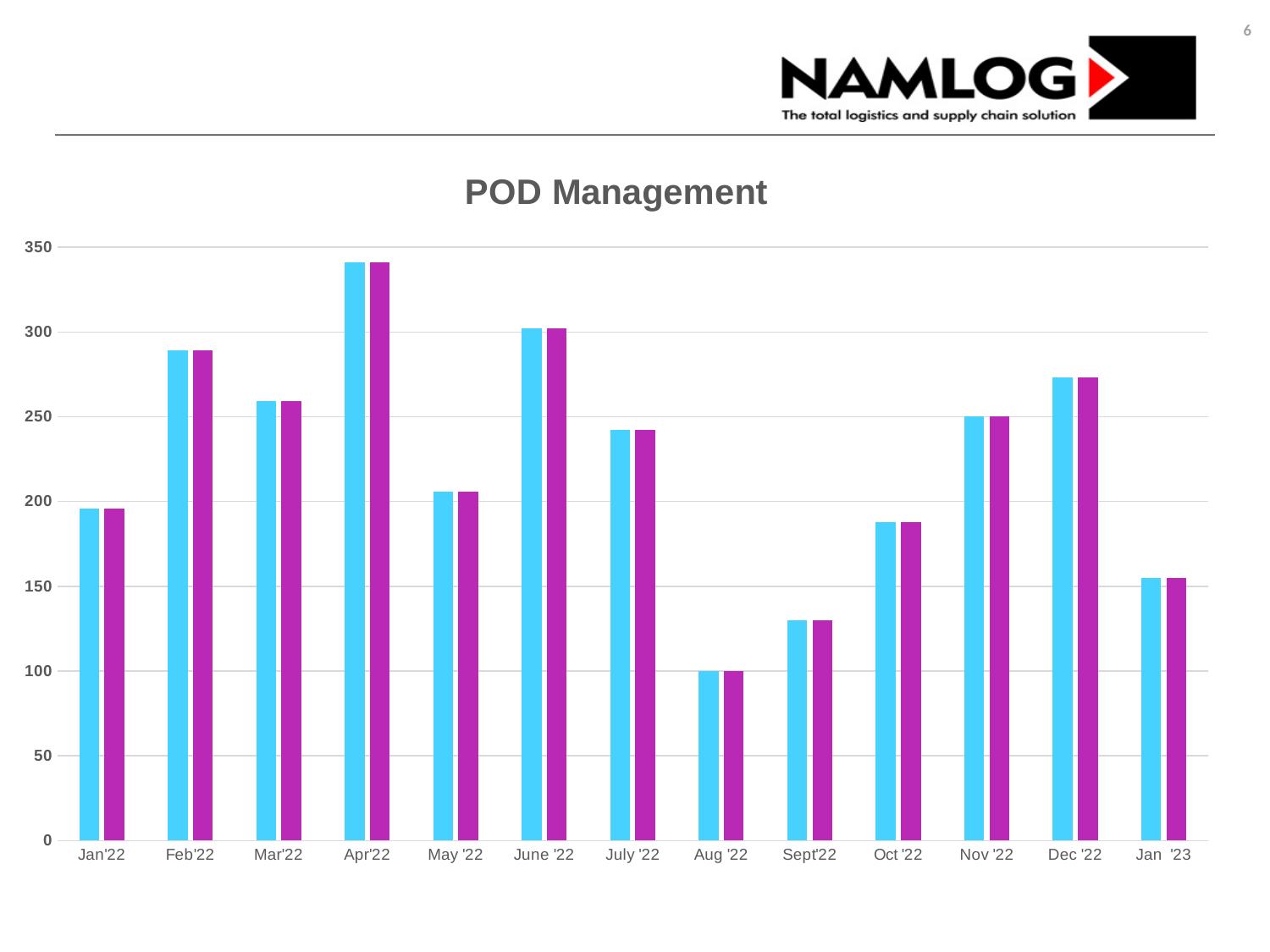
What value do the bars for Aug '22 reach on the axis? 100 What is the title of the chart? POD Management Is the value for Apr'22 greater or less than 300? greater Is the value for Sept'22 greater or less than 150? less Which month has the lowest bars in the chart? Aug '22 What kind of chart is shown on the slide? bar chart Which is larger, the value for Feb'22 or the value for Mar'22? Feb'22 How many months are shown on the x axis of the chart? 13 Is the value for Dec '22 greater or less than 250? greater What value do the bars for Nov '22 reach on the axis? 250 Which month has the highest bars in the chart? Apr'22